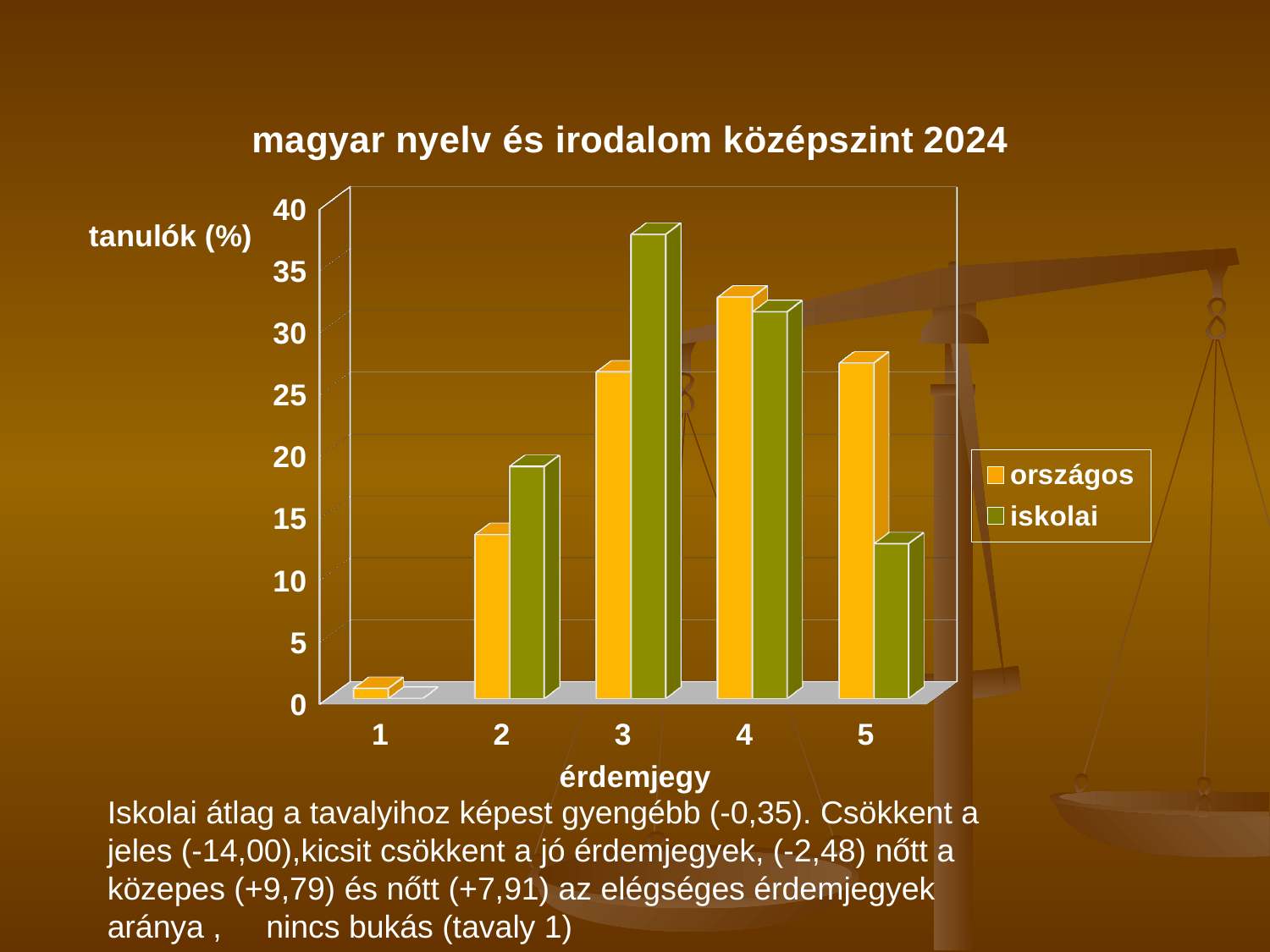
Which grade has the lowest value for the iskolai series? 1 Which grade has the highest value for the iskolai series? 3 Which grade has the highest value for the országos series? 4 For grade 5, which series has the larger value, országos or iskolai? országos Which grade has the lowest value for the országos series? 1 For grade 3, which series has the larger value, országos or iskolai? iskolai How many series does the legend list? 2 What kind of chart is shown on the slide? bar chart What is the title of the chart? magyar nyelv és irodalom középszint 2024 Is the országos value for grade 2 greater or less than 15? less How many grade categories (érdemjegy) are shown on the x axis? 5 Is the iskolai value for grade 3 greater or less than 35? greater